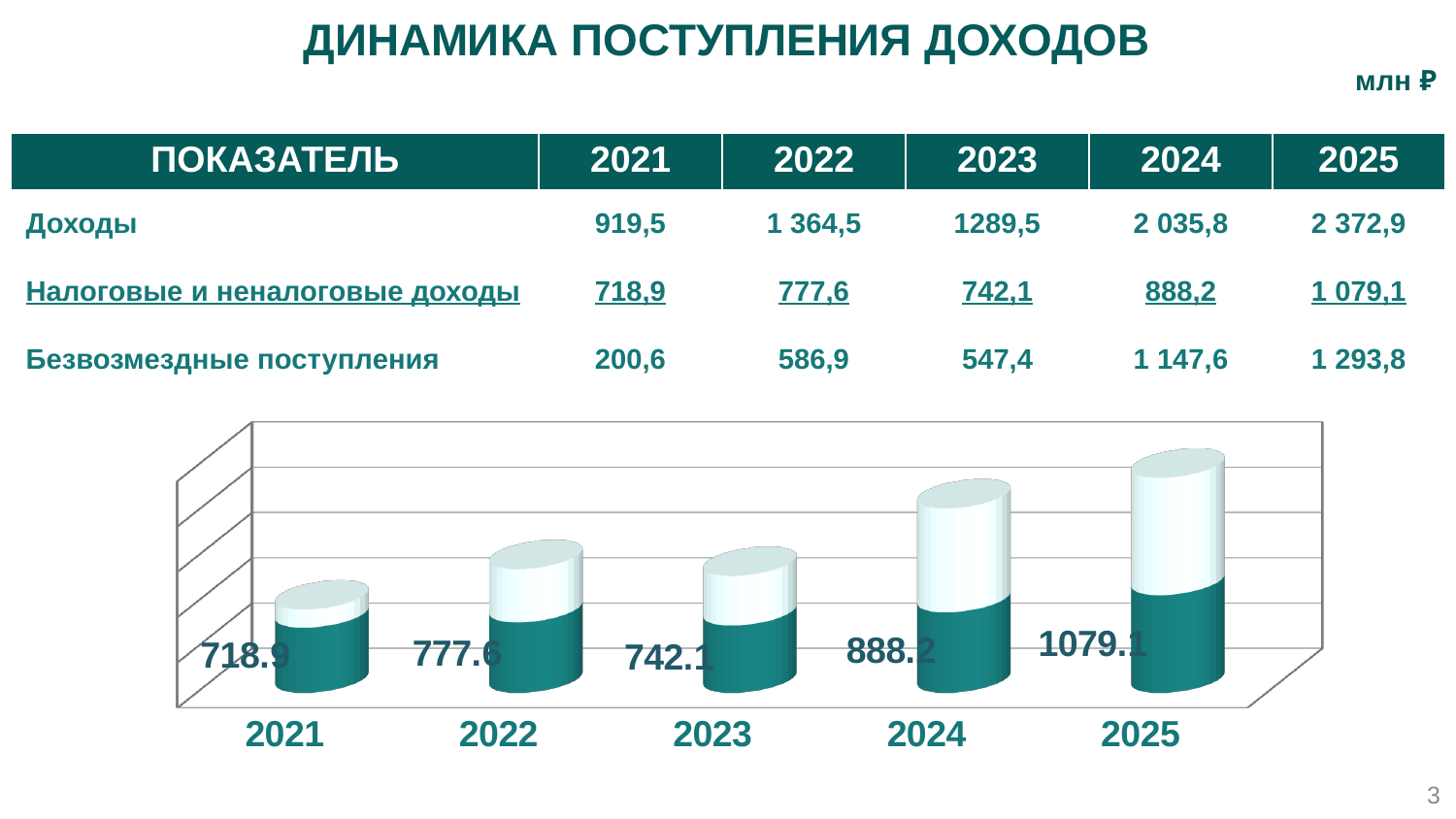
What is the labelled value of the dark segment for 2025 in the chart? 1079.1 What is the difference between the labelled values for 2025 and 2024 in the chart? 190.9 Which year has the tallest total bar in the chart? 2025 What type of chart is shown on the slide? bar chart How many years are shown along the x axis of the chart? 5 Do the labelled values in the chart rise or fall from 2023 to 2025? rise What is the labelled value of the dark segment for 2021 in the chart? 718.9 What is the labelled value of the dark segment for 2023 in the chart? 742.1 Which labelled value is larger in the chart, 2022 or 2023? 2022 Which year has the lowest labelled value in the chart? 2021 What is the title of the slide containing the chart? ДИНАМИКА ПОСТУПЛЕНИЯ ДОХОДОВ Which year has the highest labelled value in the chart? 2025